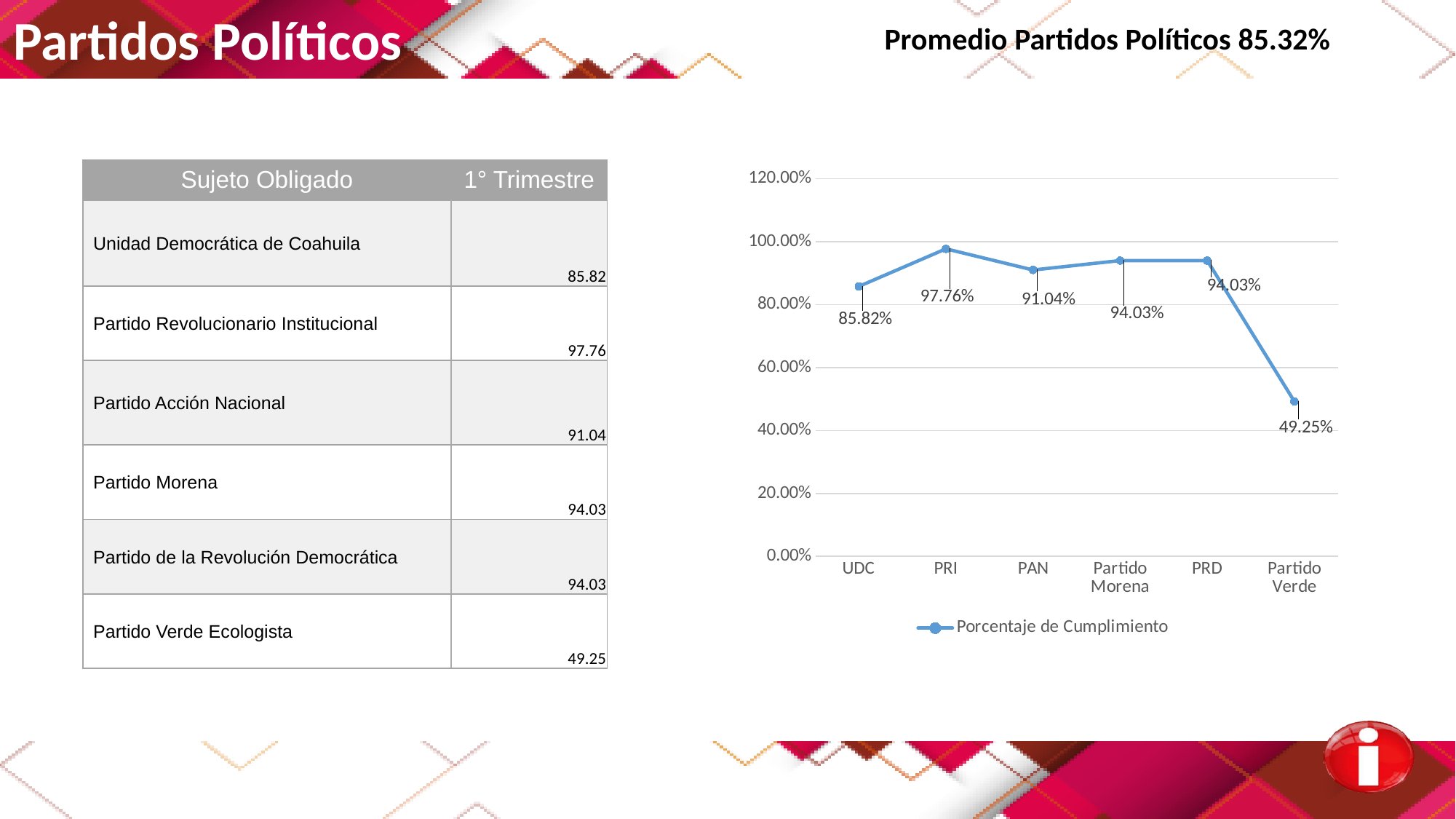
What is the value for Partido Verde in the chart? 49.25% What is the value for UDC in the chart? 85.82% Is the value for Partido Verde greater or less than 60.00%? less Which category has the lowest value in the chart? Partido Verde What is the difference between the values for PRI and Partido Verde? 48.51% What is the value for PRI in the chart? 97.76% What kind of chart is shown on the slide? line chart Which is larger, the value for PAN or the value for UDC? PAN What is the value for PAN in the chart? 91.04% Which category has the highest value in the chart? PRI What series name does the chart legend show? Porcentaje de Cumplimiento How many categories are plotted on the x axis of the chart? 6